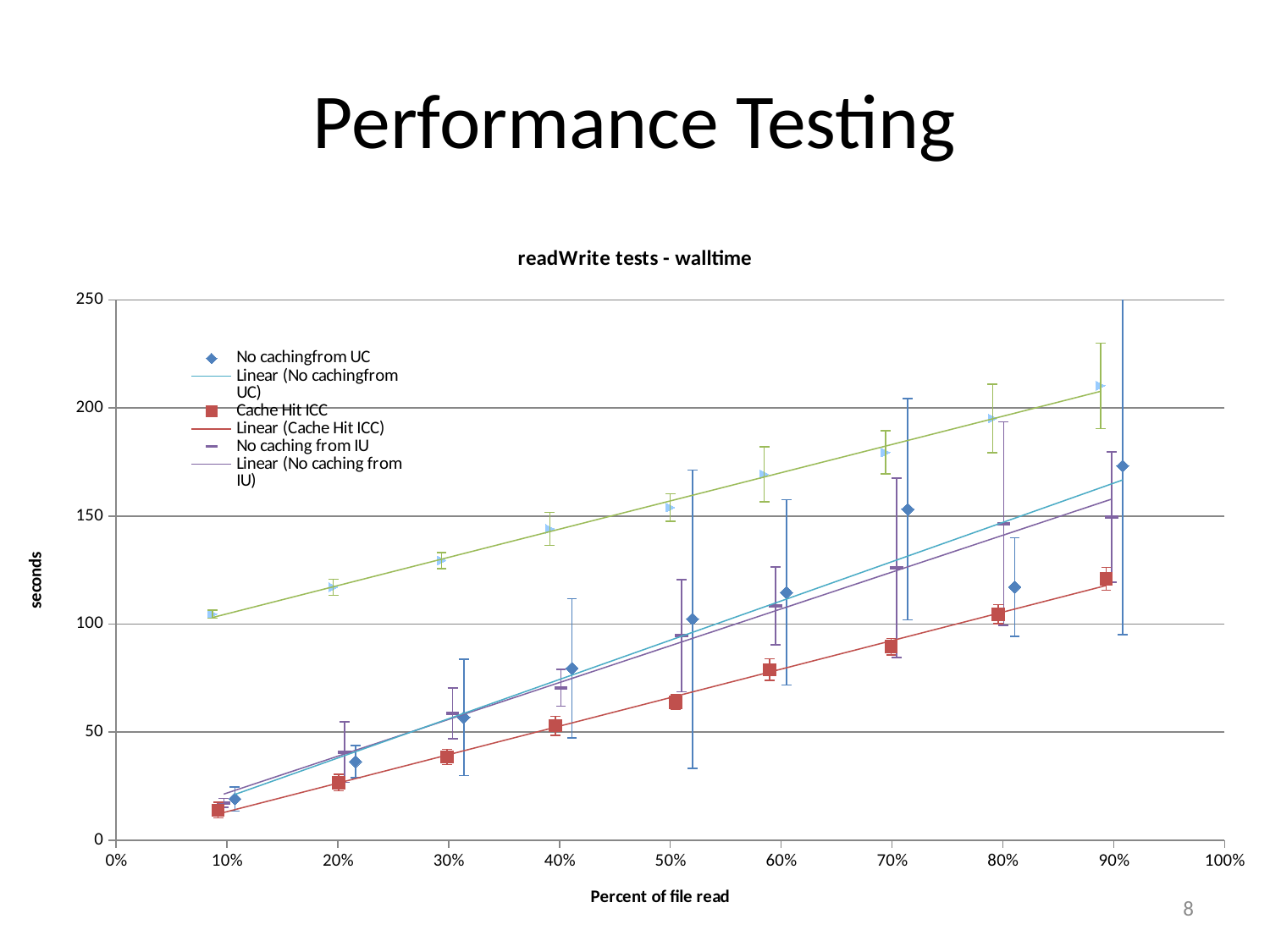
Do the Cache Hit ICC values rise or fall as the percent of file read increases? Rise How many entries does the chart legend list? 6 At 90% of file read, which is larger: the No caching from UC value or the Cache Hit ICC value? No caching from UC Is the No caching from UC value at 20% greater or less than 50 seconds? less What is the title of the chart? readWrite tests - walltime What kind of chart is shown on the slide? Scatter chart Is the No caching from IU value at 70% greater or less than 100 seconds? greater How many data points are plotted for the Cache Hit ICC series? 9 Is the Cache Hit ICC value at 10% greater or less than 50 seconds? less What is the label of the vertical axis? seconds